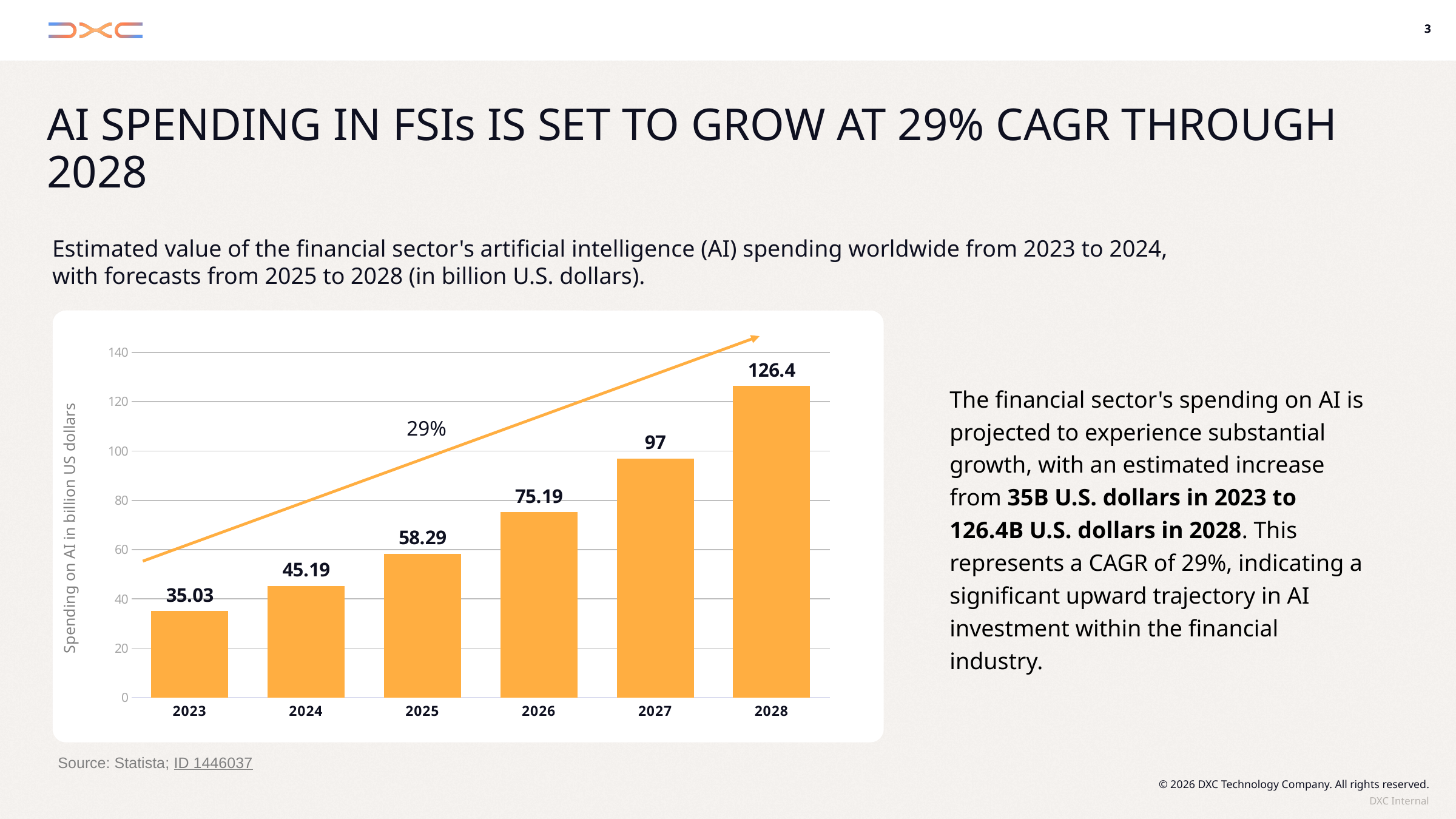
What is the value for 2028? 126.4 Which is larger, the value for 2027 or the value for 2026? 2027 Is the value for 2027 greater or less than 100? less Which year has the lowest value? 2023 What kind of chart is shown? bar chart Do the values rise or fall from 2023 to 2028? rise What is the difference between the values for 2025 and 2024? 13.1 Which year has the highest value? 2028 What is the difference between the values for 2028 and 2023? 91.37 What is the value for 2023? 35.03 What is the value for 2026? 75.19 How many years are shown on the x axis? 6